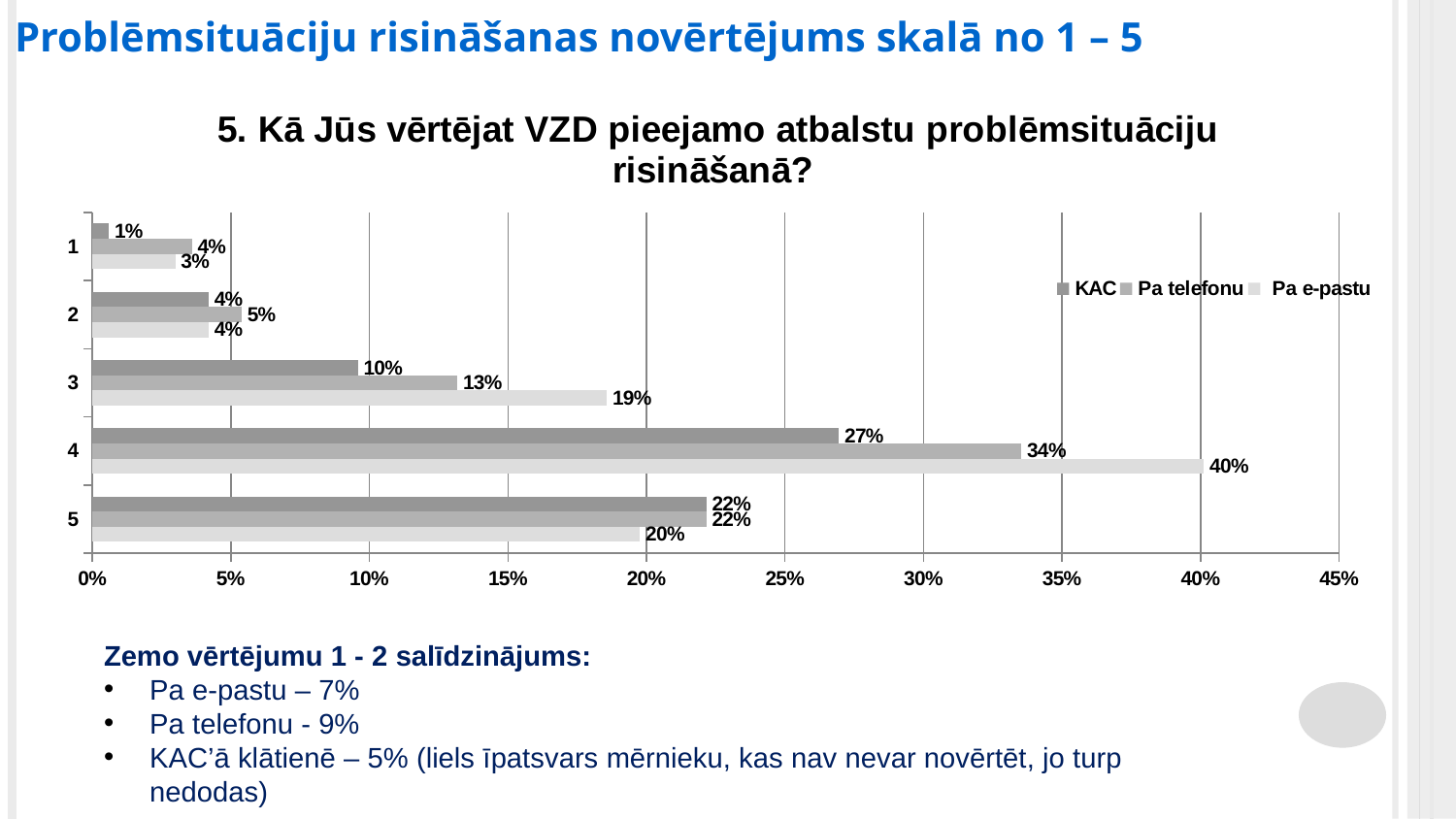
What is the difference between Pa e-pastu and Pa telefonu in category 3? 6% What kind of chart is shown on the slide? Bar chart How many series does the legend list? 3 How many categories are shown on the vertical axis? 5 What is the value for KAC in category 3? 10% What is the difference between Pa e-pastu and KAC in category 4? 13% Which category has the highest value for Pa telefonu? 4 Which category has the lowest value for KAC? 1 What is the value for Pa telefonu in category 1? 4% What is the value for Pa e-pastu in category 4? 40% Which is larger in category 5: KAC or Pa e-pastu? KAC What are the three series listed in the legend? KAC, Pa telefonu, Pa e-pastu